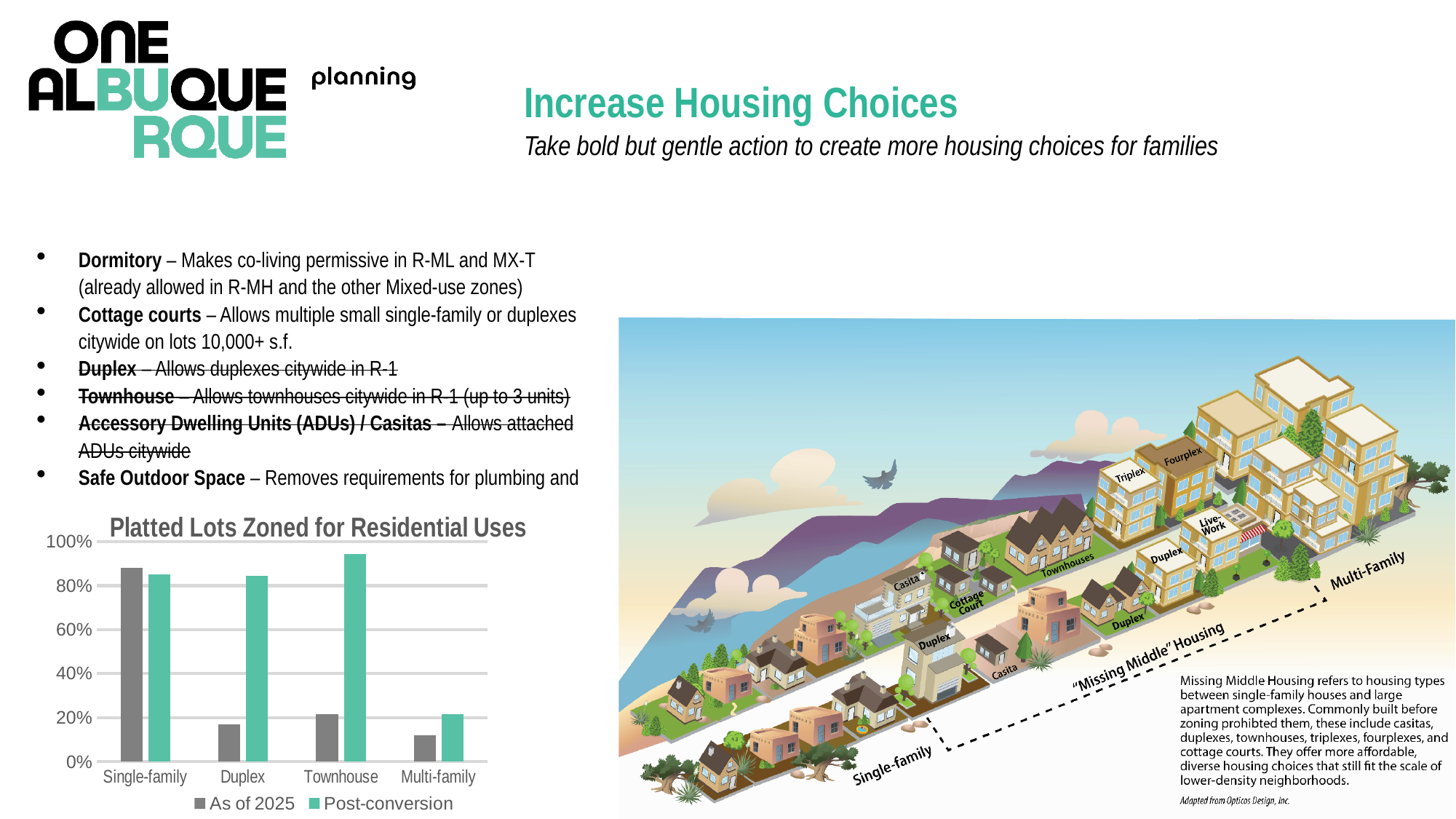
In the "Platted Lots Zoned for Residential Uses" chart, is the "Post-conversion" value for Townhouse greater or less than 80%? greater Which category has the lowest "As of 2025" value in the "Platted Lots Zoned for Residential Uses" chart? Multi-family Which category has the highest "Post-conversion" value in the "Platted Lots Zoned for Residential Uses" chart? Townhouse What are the two series named in the legend of the "Platted Lots Zoned for Residential Uses" chart? As of 2025 and Post-conversion How many series does the legend of the "Platted Lots Zoned for Residential Uses" chart list? 2 In the "Platted Lots Zoned for Residential Uses" chart, is the "Post-conversion" value for Multi-family greater or less than 40%? less In the "Platted Lots Zoned for Residential Uses" chart, which is larger for Duplex: the "As of 2025" value or the "Post-conversion" value? Post-conversion Which category has the lowest "Post-conversion" value in the "Platted Lots Zoned for Residential Uses" chart? Multi-family In the "Platted Lots Zoned for Residential Uses" chart, is the "As of 2025" value for Duplex greater or less than 20%? less How many categories are shown on the x axis of the "Platted Lots Zoned for Residential Uses" chart? 4 Which category has the highest "As of 2025" value in the "Platted Lots Zoned for Residential Uses" chart? Single-family What kind of chart is "Platted Lots Zoned for Residential Uses"? bar chart